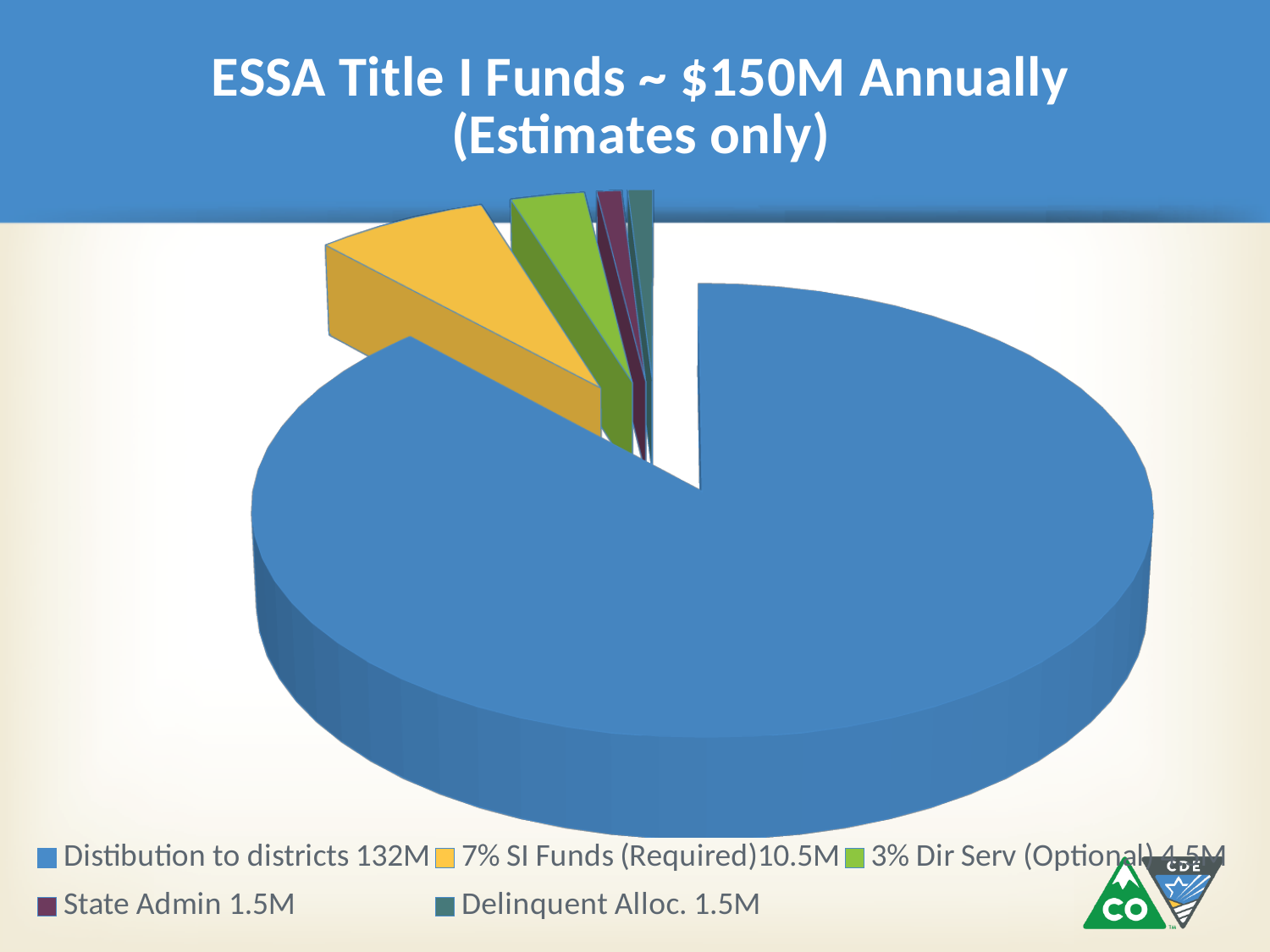
What is the value for State Admin? 1.5M What is the value for Distibution to districts? 132M What colour is the slice for Distibution to districts? Blue What is the title of the chart? ESSA Title I Funds ~ $150M Annually (Estimates only) Which category has the largest slice of the pie? Distibution to districts What is the value for 7% SI Funds (Required)? 10.5M What is the total of all the slices in the pie chart? 150M What is the value for 3% Dir Serv (Optional)? 4.5M How many slices does the pie chart have? 5 Which is larger, 7% SI Funds (Required) or 3% Dir Serv (Optional)? 7% SI Funds (Required) What is the difference between 7% SI Funds (Required) and 3% Dir Serv (Optional)? 6M What kind of chart is shown on the slide? Pie chart